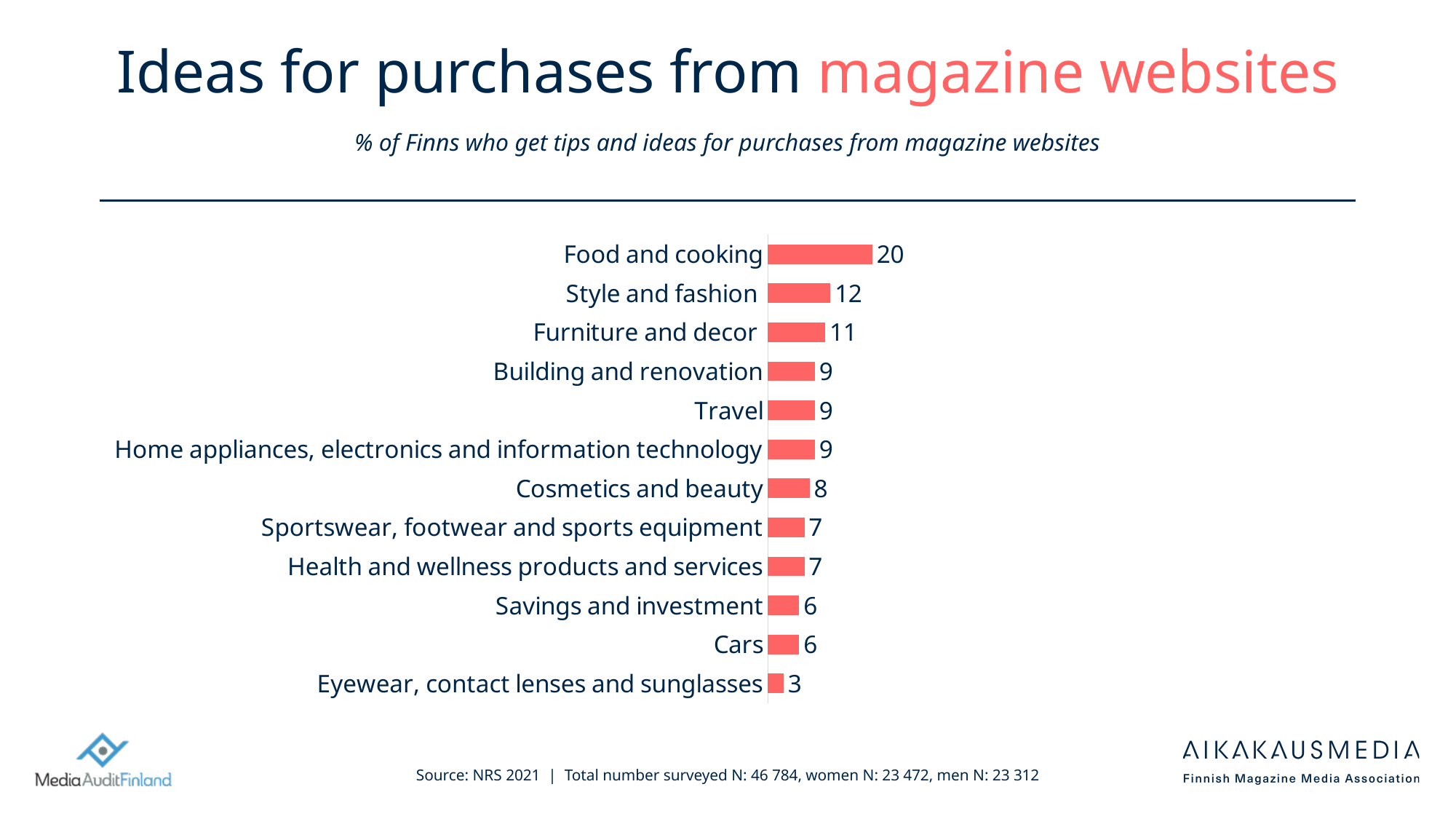
What is the difference between the values for Savings and investment and Eyewear, contact lenses and sunglasses? 3 How many categories are shown in the chart? 12 What is the value for Eyewear, contact lenses and sunglasses? 3 Which category has the highest value? Food and cooking What is the value for Food and cooking? 20 What is the value for Furniture and decor? 11 What colour are the bars in the chart? Red Which category has the lowest value? Eyewear, contact lenses and sunglasses Which is larger, the value for Travel or the value for Cars? Travel What is the value for Cosmetics and beauty? 8 What is the difference between the values for Food and cooking and Style and fashion? 8 What kind of chart is shown on the slide? Bar chart